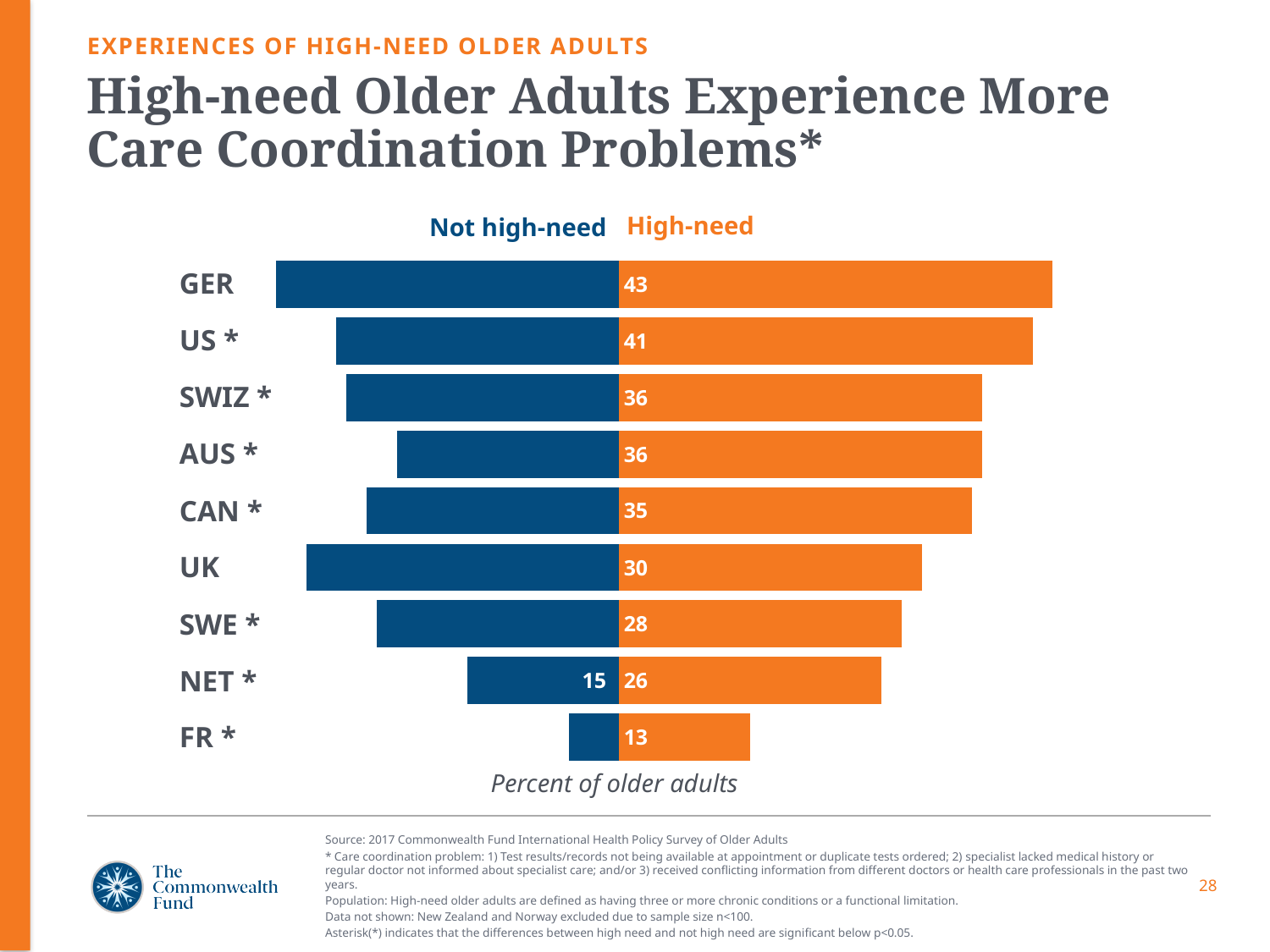
Which country has the lowest High-need value? FR * How many series does the legend list? 2 What is the Not high-need value for NET *? 15 What is the High-need value for GER? 43 What is the High-need value for FR *? 13 What kind of chart is shown on the slide? Bar chart What is the difference between the High-need values for GER and US *? 2 Which country has the highest High-need value? GER What is the High-need value for CAN *? 35 How many countries are shown in the chart? 9 For NET *, what is the difference between the High-need and Not high-need values? 11 Which has the larger High-need value, UK or SWE *? UK